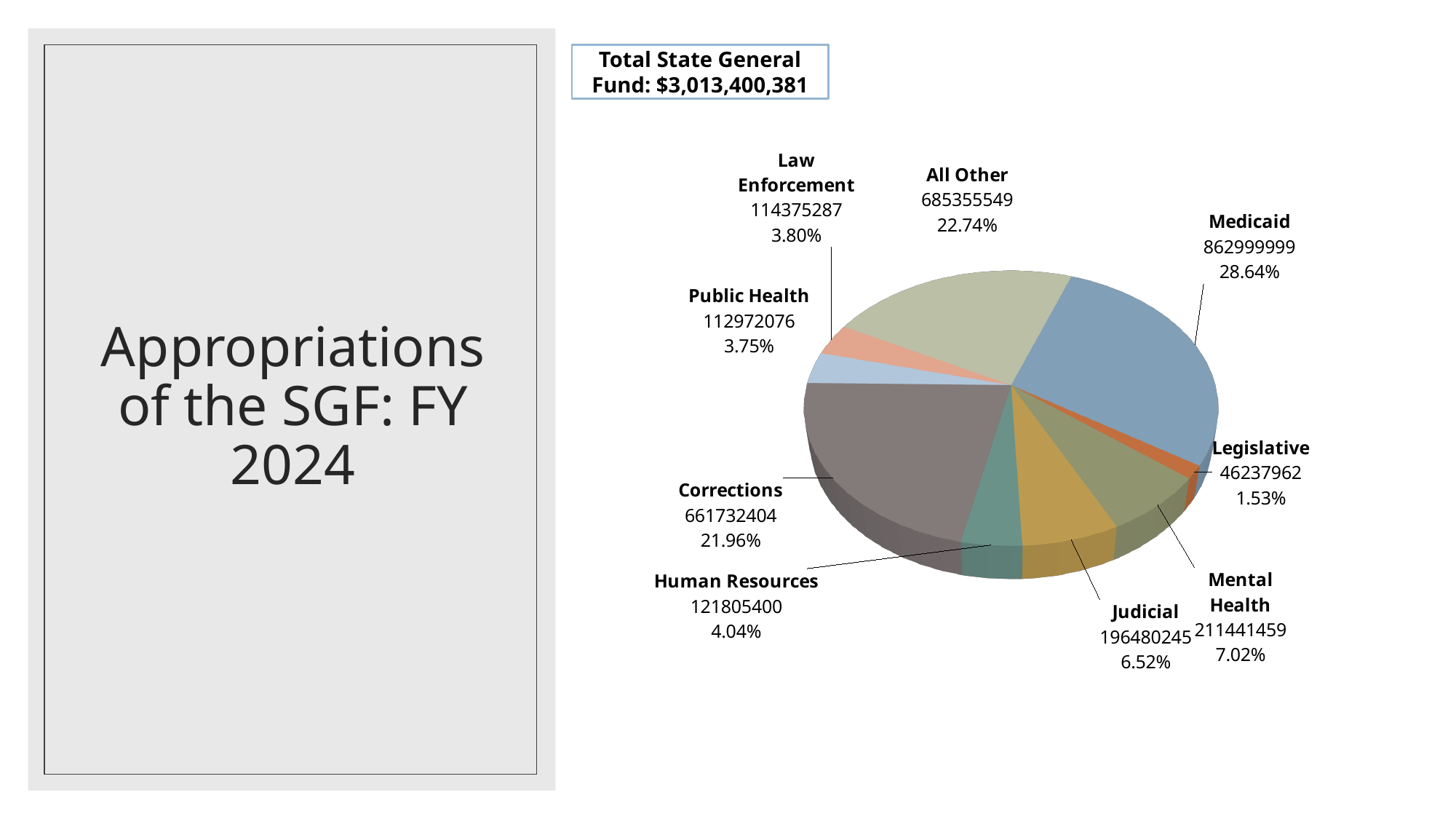
What total State General Fund amount is stated in the box above the chart? $3,013,400,381 What is the value shown for Human Resources? 121805400 What is the value shown for Judicial? 196480245 Which category has the largest share of the pie? Medicaid Which is larger, All Other or Corrections? All Other What percentage share does Law Enforcement have? 3.80% What is the value shown for Medicaid? 862999999 What percentage share does Corrections have? 21.96% Which category has the smallest share of the pie? Legislative How many categories does the pie chart show? 9 What is the difference between the Mental Health value and the Judicial value? 14961214 What type of chart is shown on the slide? Pie chart